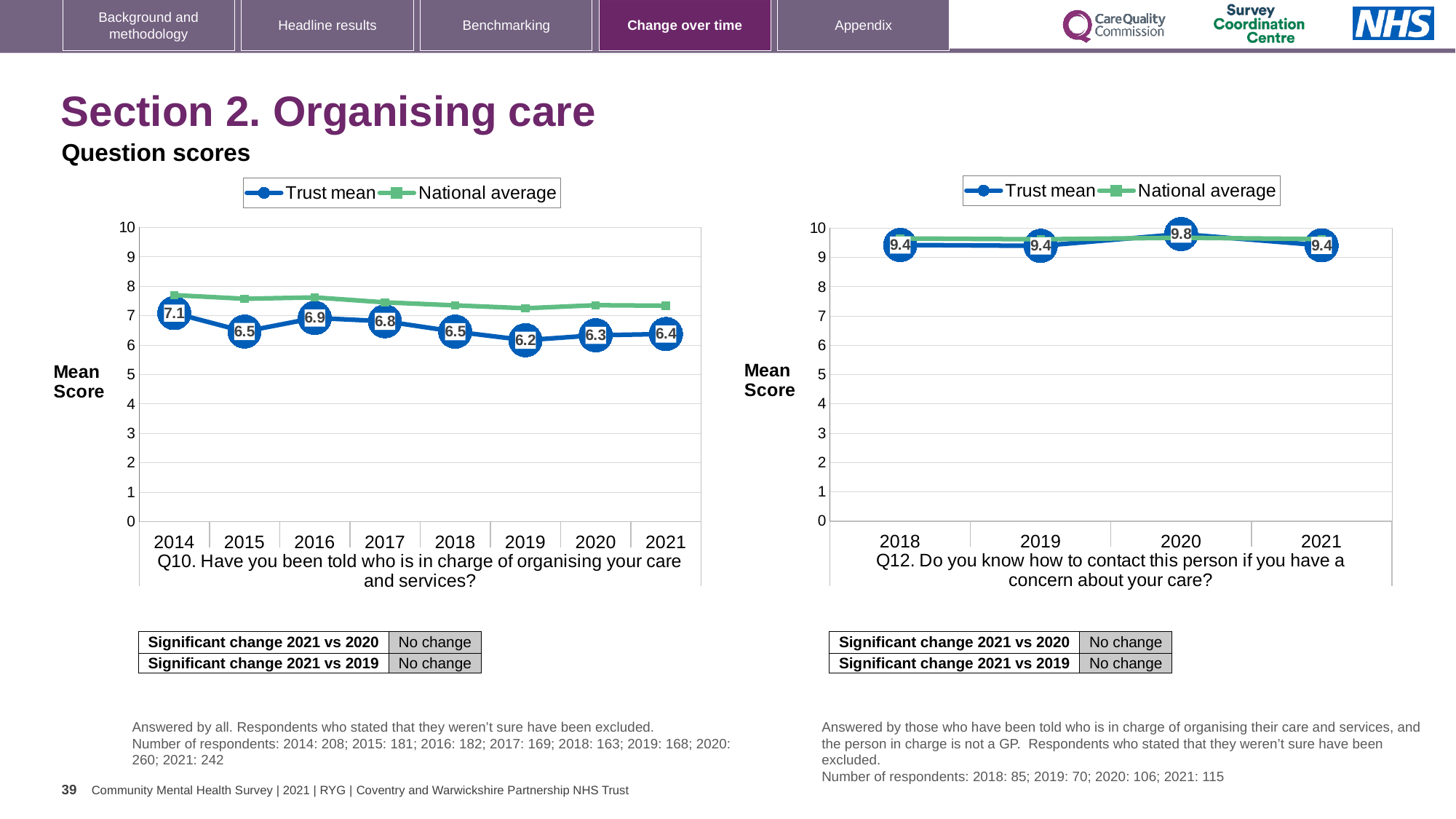
In the Q10 chart on the left, how many years are plotted on the x axis? 8 In the Q10 chart on the left, which year has the highest Trust mean? 2014 In the Q12 chart on the right, what is the Trust mean for 2020? 9.8 What type of chart is the Q12 chart on the right? Line chart In the Q10 chart on the left, what is the Trust mean for 2014? 7.1 In the Q10 chart on the left, is the Trust mean higher in 2016 or in 2018? 2016 In the Q12 chart on the right, which year has the highest Trust mean? 2020 In the Q10 chart on the left, is the National average for 2014 greater or less than 7? greater In the Q10 chart on the left, which year has the lowest Trust mean? 2019 In the Q12 chart on the right, how many series does the legend list? 2 In the Q10 chart on the left, what is the difference between the Trust mean in 2014 and in 2019? 0.9 In the Q10 chart on the left, what is the Trust mean for 2021? 6.4